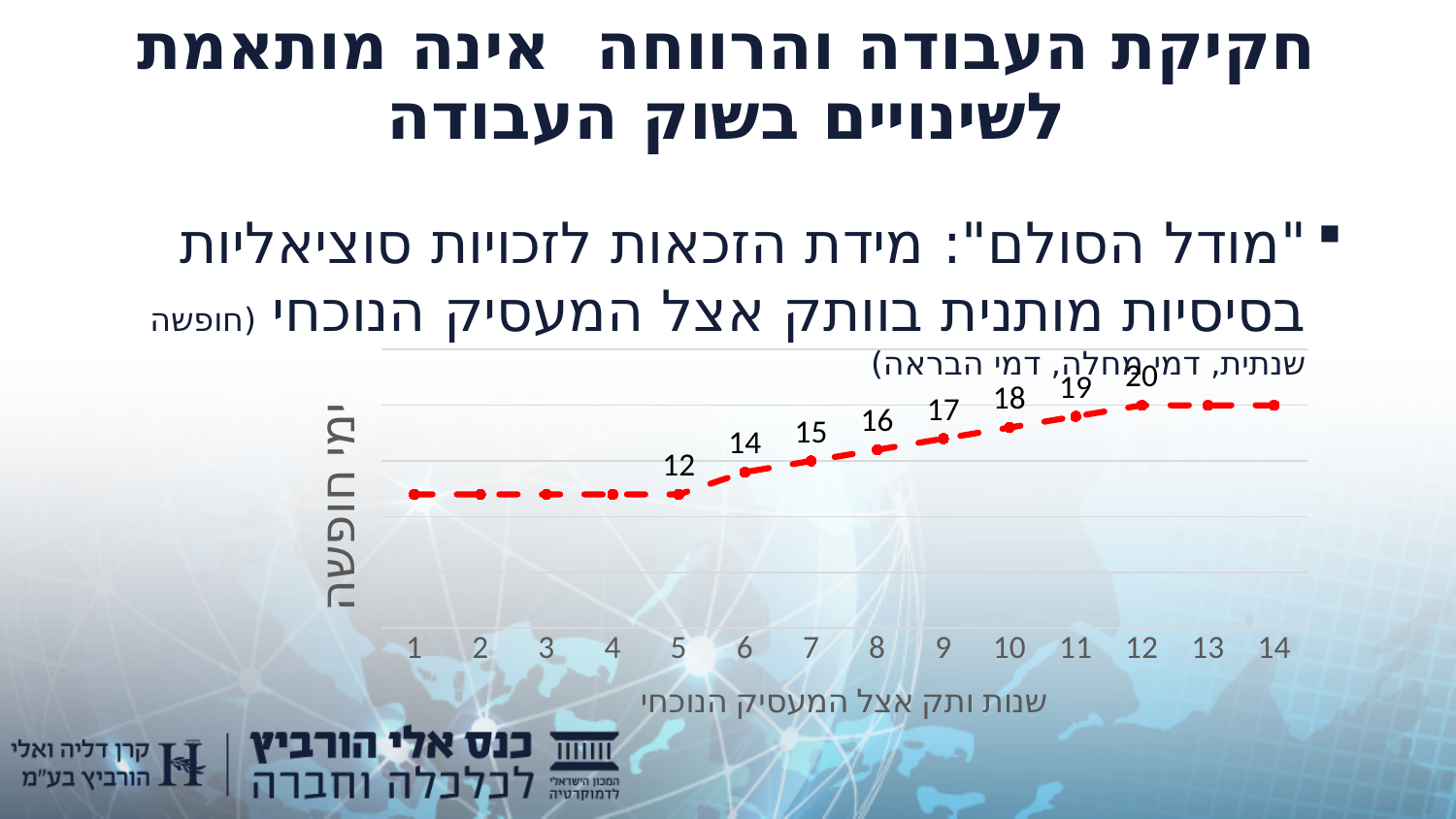
What is the difference between the values at year 12 and year 5? 8 What is the value plotted for year 6 of tenure? 14 Which is larger, the value at year 11 or the value at year 7? Year 11 What is the value plotted for year 5 of tenure? 12 What is the value plotted for year 12 of tenure? 20 Do the values rise or fall as tenure increases from year 5 to year 12? Rise What is the title of the x axis? שנות ותק אצל המעסיק הנוכחי How many tenure years are shown on the x axis? 14 What is the difference between the values at year 9 and year 6? 3 What kind of chart is shown on the slide? Line chart What is the value plotted for year 10 of tenure? 18 What is the value plotted for year 8 of tenure? 16